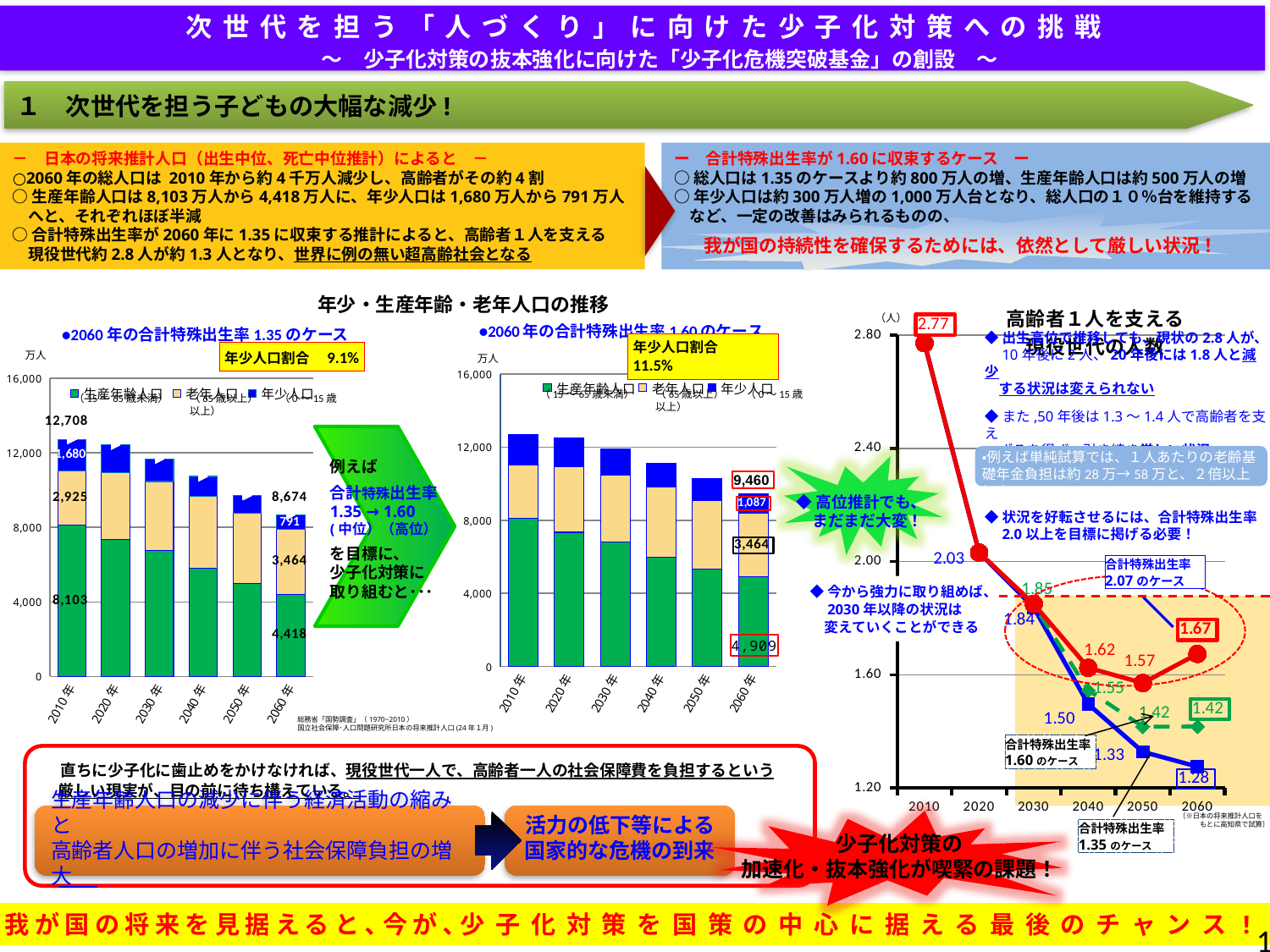
In the middle bar chart (2060年の合計特殊出生率1.60のケース), what is the total population labelled for 2060年? 9,460 In the right line chart (高齢者1人を支える現役世代の人数), does the red line generally rise or fall from 2010 to 2050? Fall What is the difference between the 2060年 total in the middle chart (9,460) and the 2060年 total in the left chart (8,674)? 786 How many year categories are shown on the x axis of the left bar chart? 6 How many series does the legend of the left bar chart list? 3 In the left bar chart (2060年の合計特殊出生率1.35のケース), what is the total population labelled for 2010年? 12,708 In the left bar chart (2060年の合計特殊出生率1.35のケース), by how much does the 生産年齢人口 fall from 2010年 (8,103) to 2060年 (4,418)? 3,685 In the left bar chart (2060年の合計特殊出生率1.35のケース), what is the 生産年齢人口 value for 2060年? 4,418 In the left bar chart (2060年の合計特殊出生率1.35のケース), what is the 年少人口 value for 2010年? 1,680 What kind of chart is the left chart titled 2060年の合計特殊出生率1.35のケース? Stacked bar chart In the right line chart (高齢者1人を支える現役世代の人数), what is the value labelled for 2010? 2.77 In the middle bar chart (2060年の合計特殊出生率1.60のケース), what is the 年少人口 value for 2060年? 1,087